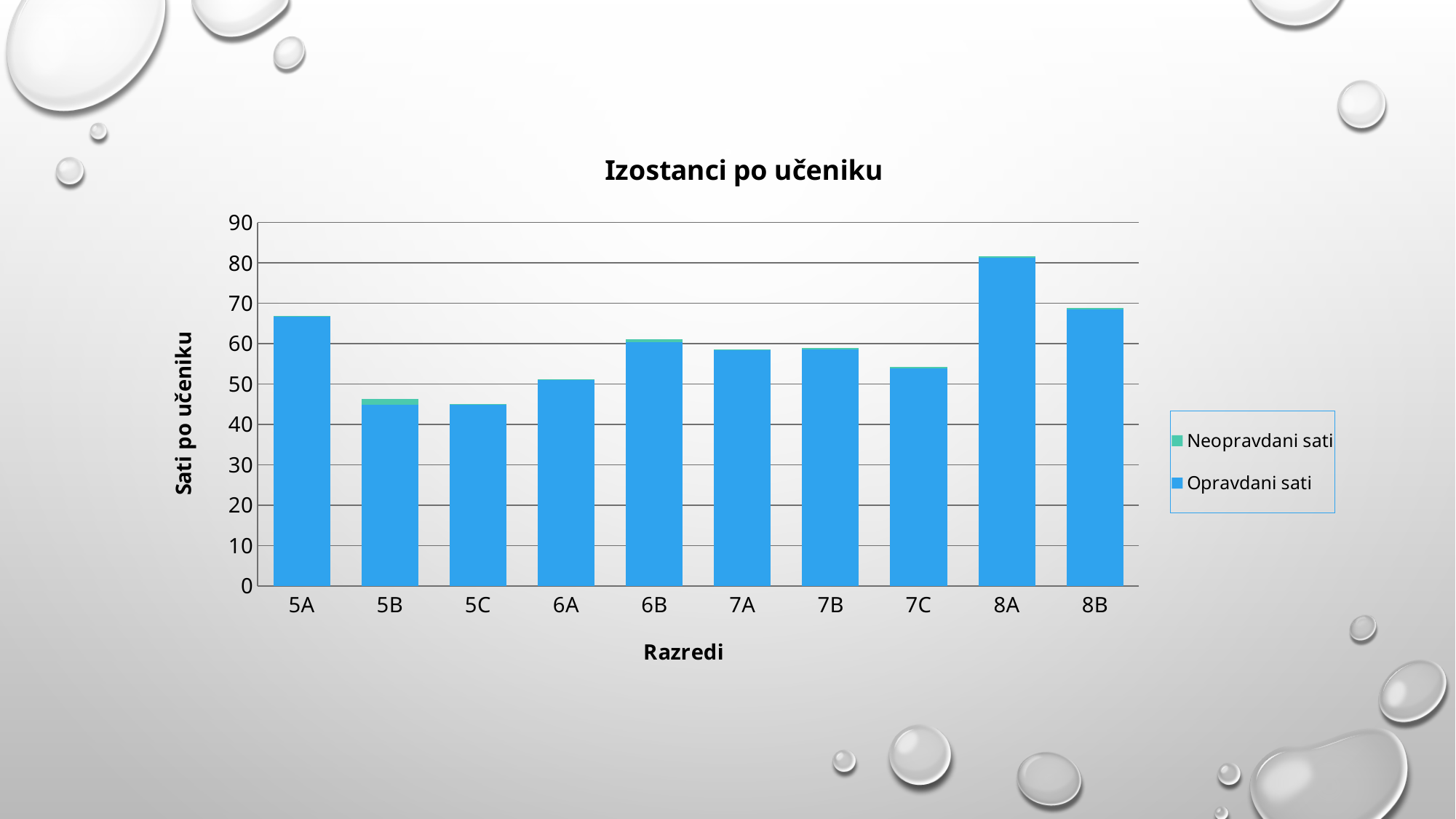
Which bar is taller, 8A or 8B? 8A How many classes (categories) are shown on the x axis? 10 What type of chart is shown on the slide? bar chart Is the total value for 5C greater or less than 50? less What is the label of the x axis? Razredi Which bar is taller, 5A or 6A? 5A What is the title of the chart? Izostanci po učeniku Is the total value for 7C greater or less than 60? less Which class has the highest total bar? 8A How many series does the legend list? 2 Is the total value for 5A greater or less than 60? greater